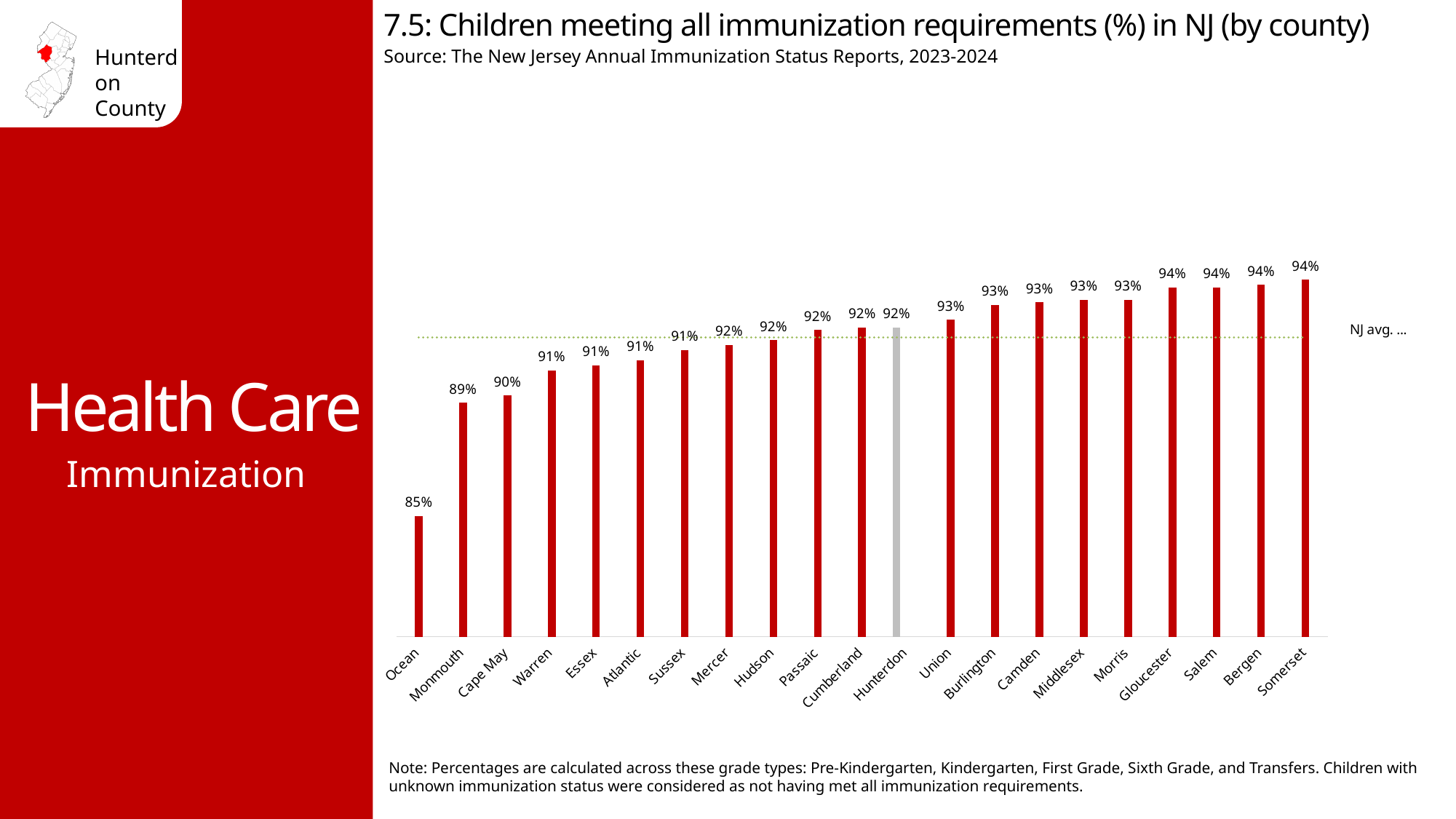
What percentage of children in Ocean County met all immunization requirements? 85% What is the value for Somerset County? 94% Which county's bar is coloured grey instead of red? Hunterdon What is the value shown for Hunterdon County? 92% What kind of chart is shown on the slide? Bar chart What is the difference in percentage points between Somerset and Ocean? 9 How many counties are shown in the chart? 21 What is the value shown for Cape May? 90% What percentage is shown for Monmouth County? 89% Do the values generally rise or fall from left to right across the counties? Rise Which county has the lowest percentage of children meeting all immunization requirements? Ocean Which has a higher value, Ocean or Monmouth? Monmouth